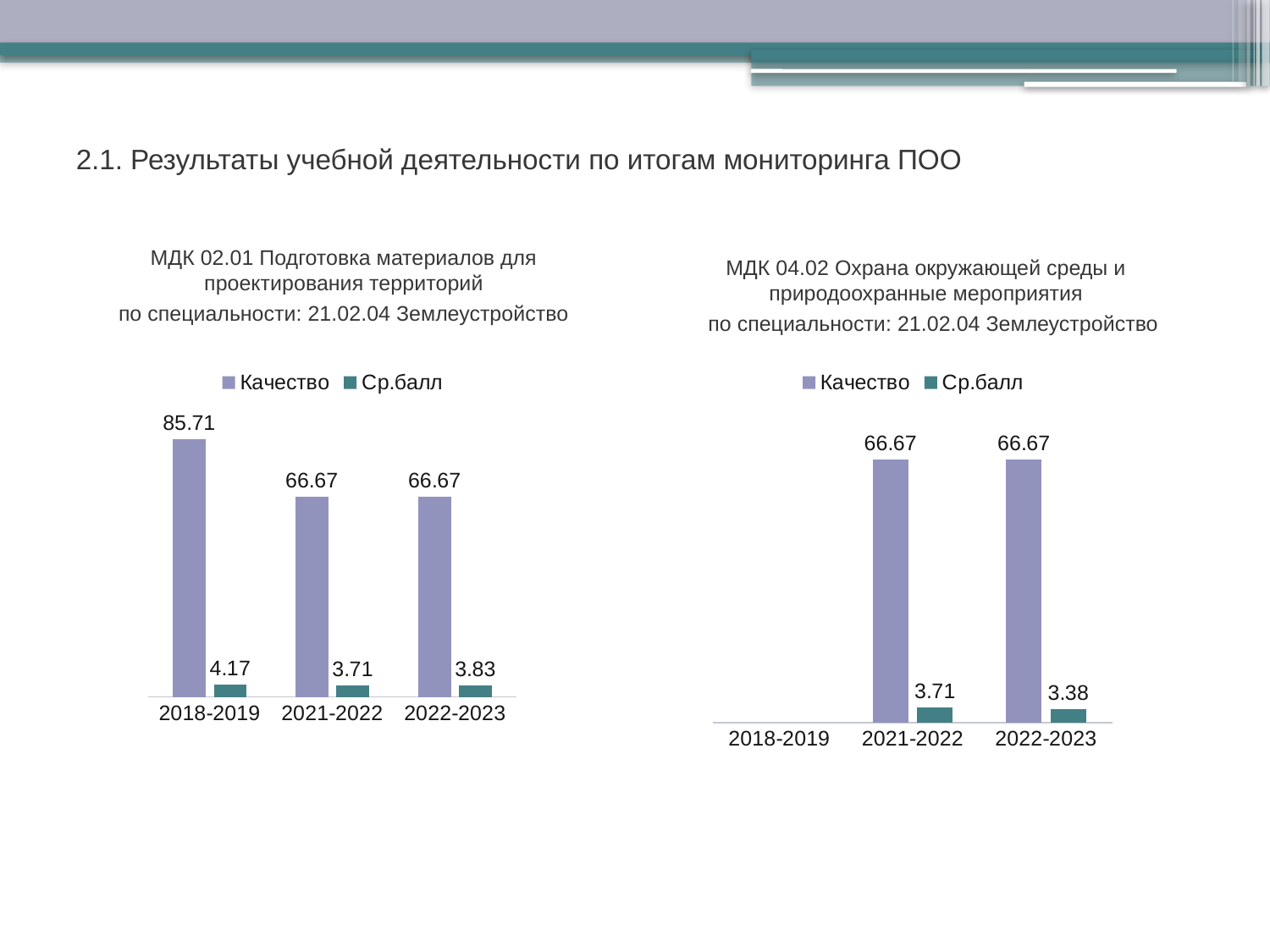
How many series does the legend of the right chart (МДК 04.02) list? 2 In the left chart (МДК 02.01), what is the difference between the Качество values for 2018-2019 and 2021-2022? 19.04 In the left chart (МДК 02.01), what is the Ср.балл value for 2022-2023? 3.83 In the left chart (МДК 02.01), which year has the highest Качество value? 2018-2019 In the left chart (МДК 02.01), which year has the lowest Ср.балл value? 2021-2022 In the right chart (МДК 04.02), what is the Качество value for 2021-2022? 66.67 In the right chart (МДК 04.02), what is the difference between the Ср.балл values for 2021-2022 and 2022-2023? 0.33 In the left chart (МДК 02.01), what is the Качество value for 2018-2019? 85.71 What kind of chart is the left chart (МДК 02.01)? bar chart In the right chart (МДК 04.02), what is the Ср.балл value for 2022-2023? 3.38 In the right chart (МДК 04.02), how many years on the x axis have bars plotted? 2 In the left chart (МДК 02.01), is the Ср.балл value for 2018-2019 larger or smaller than the Ср.балл value for 2022-2023? larger